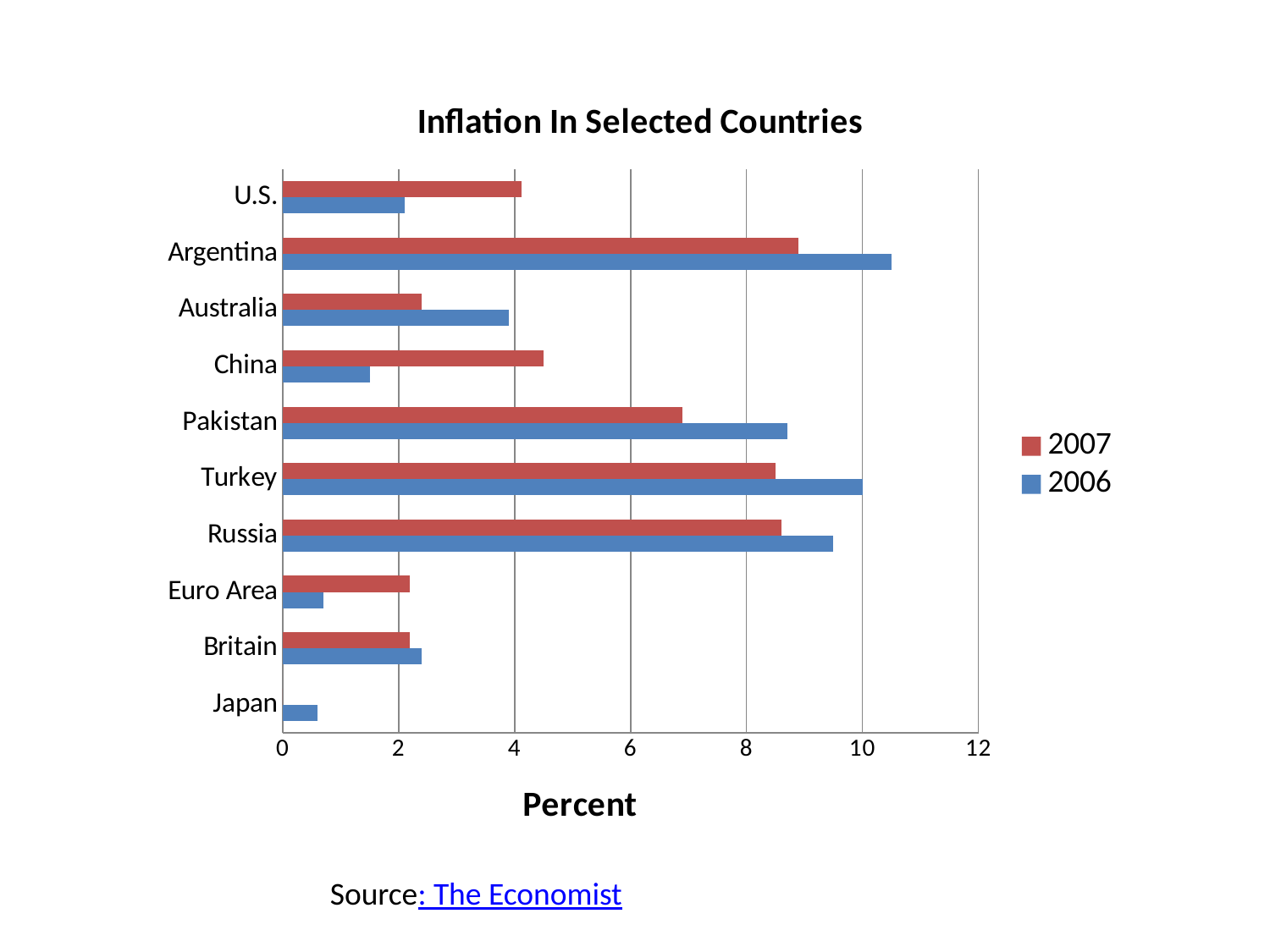
Is the 2007 value for China greater or less than 4? greater How many countries or regions are listed on the chart? 10 Is the 2006 value for Argentina greater or less than 10? greater For China, which year has the larger inflation value, 2006 or 2007? 2007 Is the 2006 value for Euro Area greater or less than 2? less For Pakistan, which year has the larger inflation value, 2006 or 2007? 2006 Which country has the lowest inflation value for 2006? Japan What kind of chart is shown on the slide? bar chart Which country has the highest inflation value for 2006? Argentina How many series does the legend list? 2 What is the title of the chart? Inflation In Selected Countries What is the 2006 inflation value for Turkey? 10